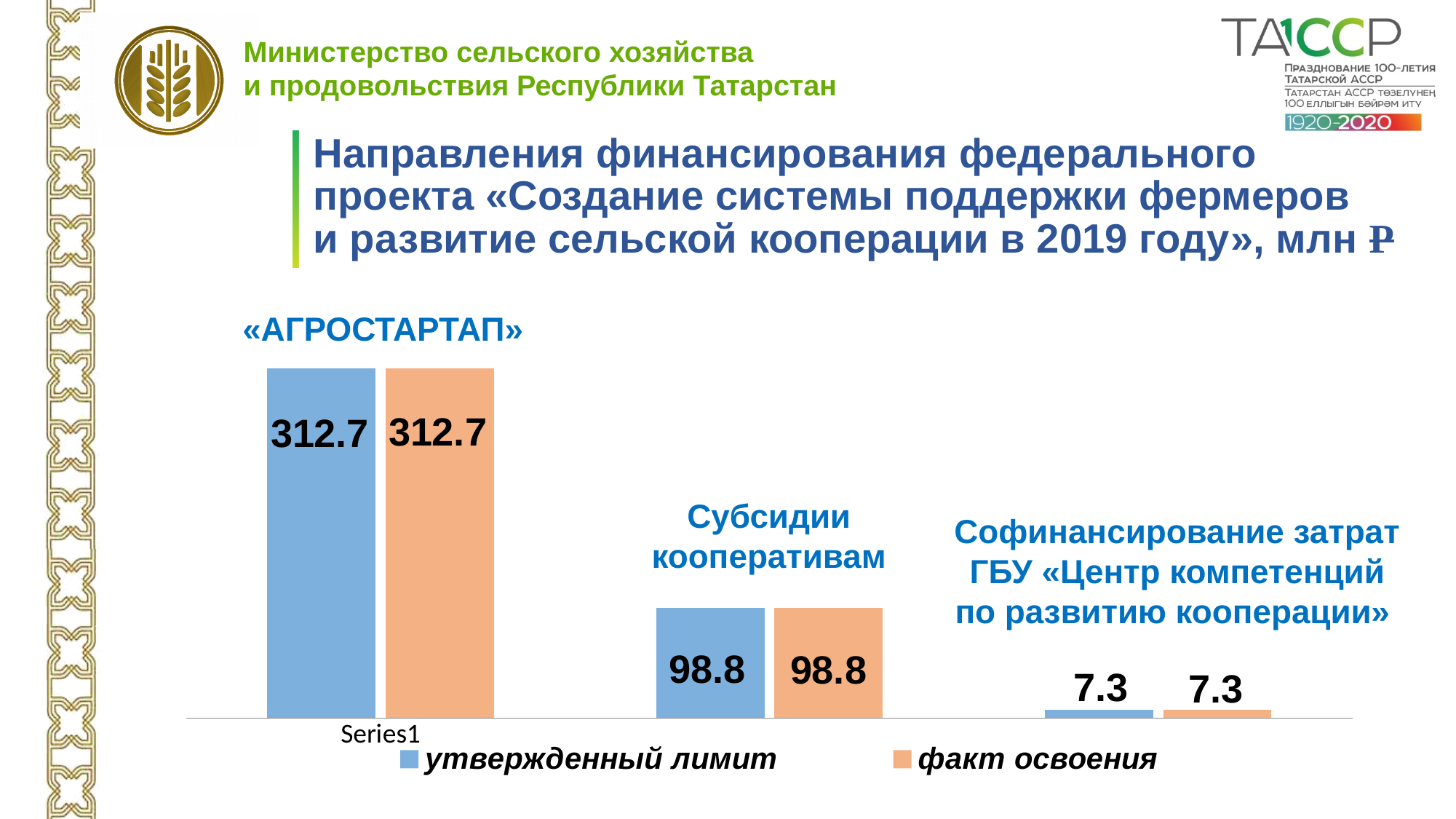
Which category has the highest approved limit (утвержденный лимит)? «АГРОСТАРТАП» How many categories are shown in the chart? 3 What is the approved limit (утвержденный лимит) for Софинансирование затрат ГБУ «Центр компетенций по развитию кооперации»? 7.3 Which category has the lowest actual disbursement (факт освоения)? Софинансирование затрат ГБУ «Центр компетенций по развитию кооперации» What is the actual disbursement (факт освоения) for «АГРОСТАРТАП»? 312.7 What is the approved limit (утвержденный лимит) for «АГРОСТАРТАП»? 312.7 How many series does the legend list? 2 Which is larger: the actual disbursement for Субсидии кооперативам or for Софинансирование затрат ГБУ «Центр компетенций по развитию кооперации»? Субсидии кооперативам What is the difference between the approved limit for «АГРОСТАРТАП» and the approved limit for Субсидии кооперативам? 213.9 What kind of chart is shown on the slide? Bar chart What is the actual disbursement (факт освоения) for Субсидии кооперативам? 98.8 Which colour represents факт освоения in the legend? Orange